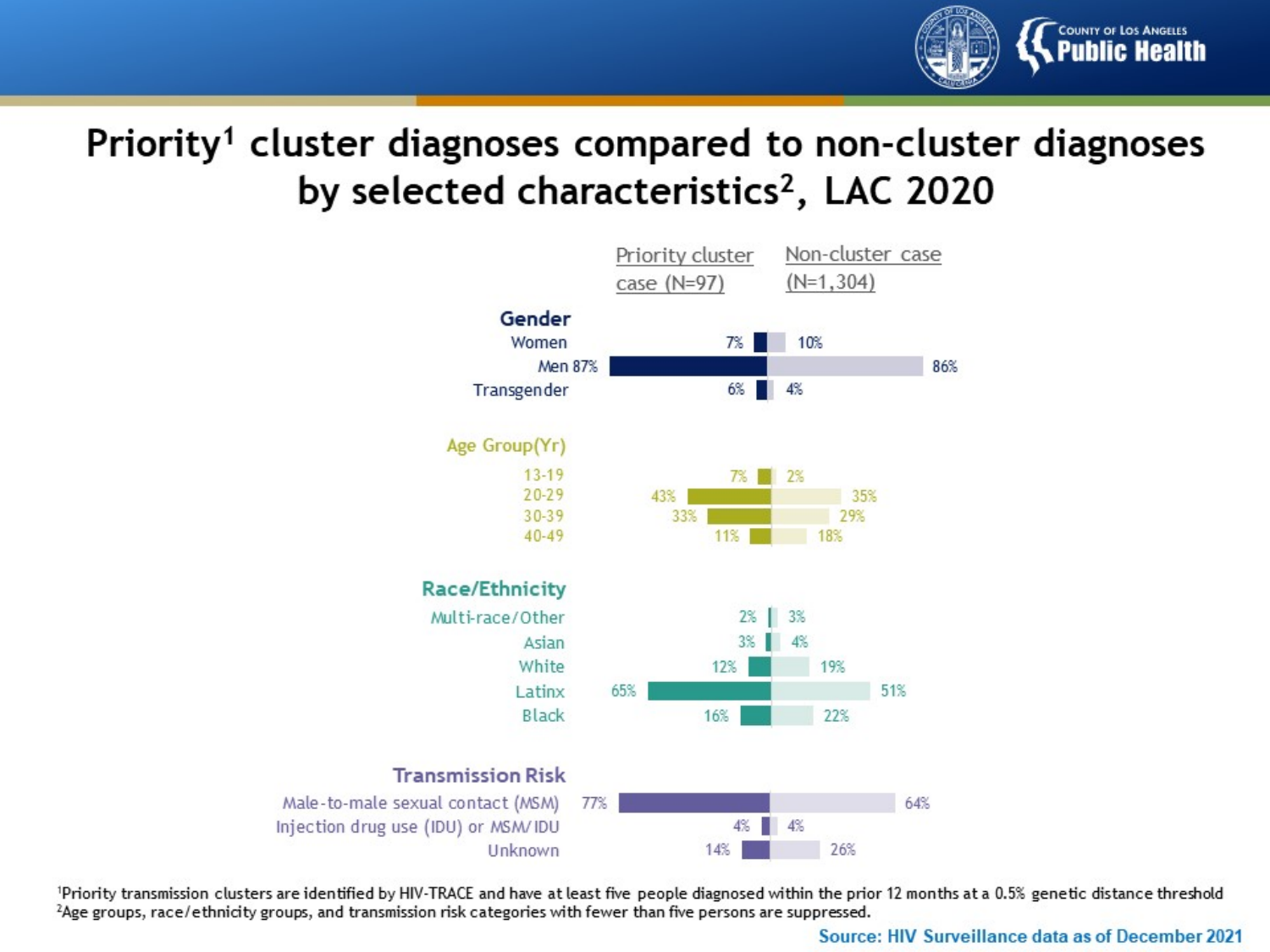
What percentage of priority cluster cases are in the 20-29 age group? 43% What percentage of non-cluster cases are Women? 10% What is the difference between the priority cluster and non-cluster percentages for Male-to-male sexual contact (MSM)? 13% Which age group has the lowest share among non-cluster cases? 13-19 What type of chart is shown on the slide? Bar chart What is the difference between the priority cluster and non-cluster percentages for Latinx? 14% What percentage of non-cluster cases are Latinx? 51% What percentage of priority cluster cases have Unknown transmission risk? 14% Which race/ethnicity group has the highest share among priority cluster cases? Latinx What percentage of priority cluster cases are Men? 87% Which is larger for the 40-49 age group: the priority cluster percentage or the non-cluster percentage? Non-cluster percentage How many series does the chart compare? 2